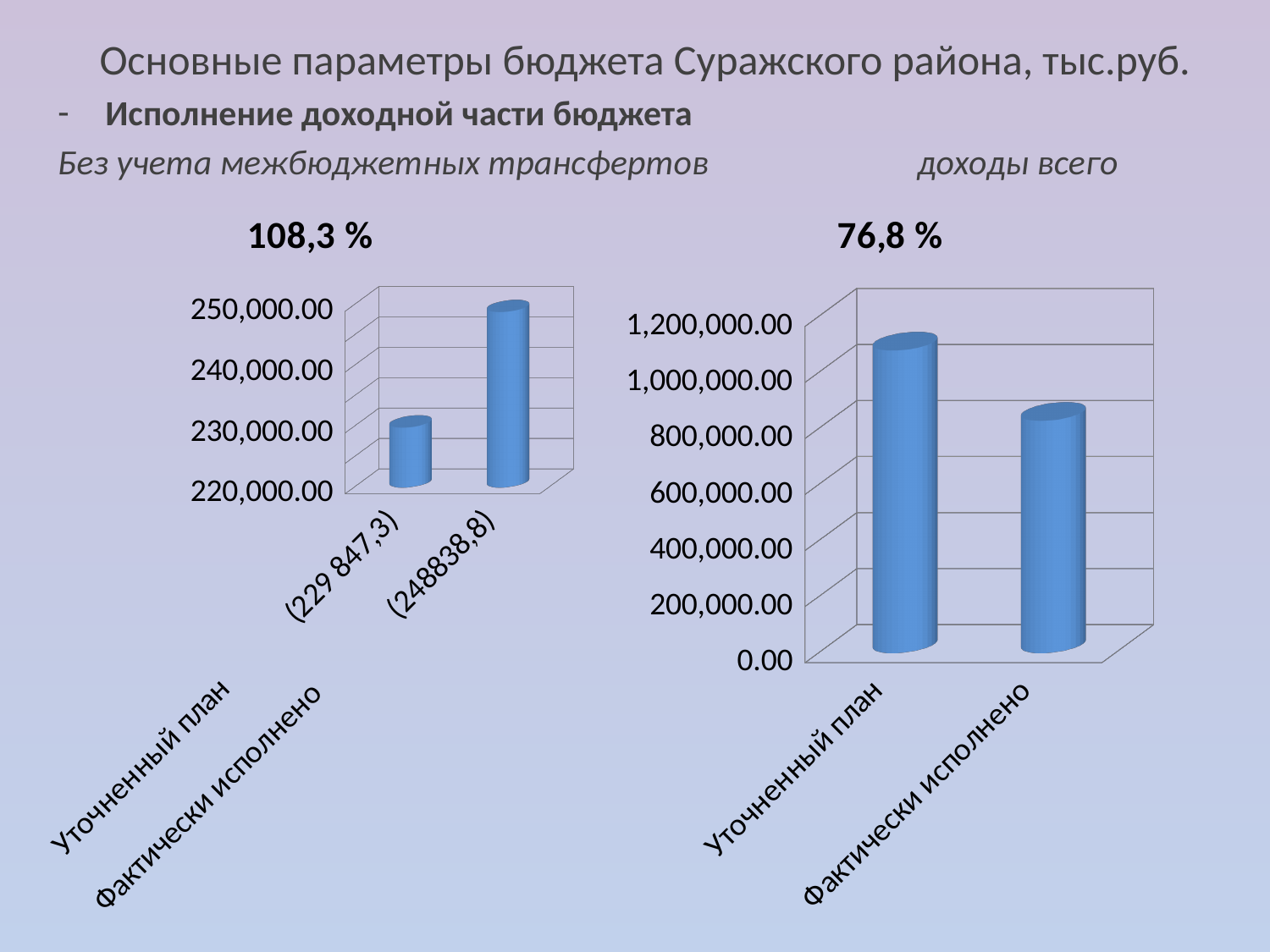
On the left chart (Без учета межбюджетных трансфертов), what value is shown in the category label for Фактически исполнено? 248838,8 On the right chart (доходы всего), is the value for Фактически исполнено greater or less than 600,000.00? greater On the left chart (Без учета межбюджетных трансфертов), what value is shown in the category label for Уточненный план? 229 847,3 What execution percentage is shown above the right chart (доходы всего)? 76,8 % On the right chart (доходы всего), is the value for Уточненный план greater or less than 1,000,000.00? greater What execution percentage is shown above the left chart (Без учета межбюджетных трансфертов)? 108,3 % How many bars does the right chart (доходы всего) have? 2 On the right chart (доходы всего), which category has the higher bar? Уточненный план On the left chart (Без учета межбюджетных трансфертов), which category has the lower bar? Уточненный план On the left chart (Без учета межбюджетных трансфертов), which category has the higher bar? Фактически исполнено What type of chart is the left chart (Без учета межбюджетных трансфертов)? bar chart On the right chart (доходы всего), is the value for Фактически исполнено greater or less than 1,000,000.00? less